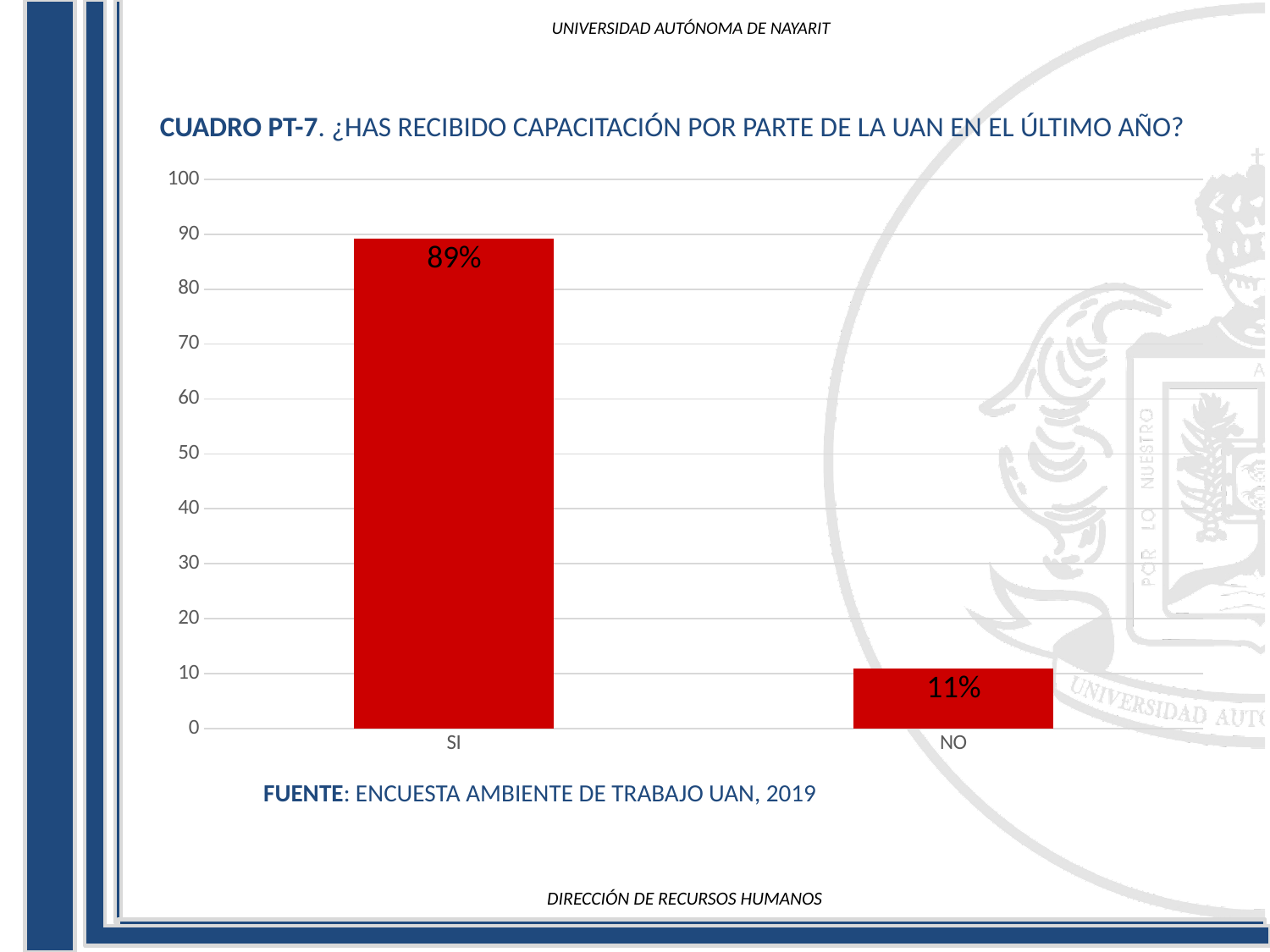
What is the value for SI? 89% What is the value for NO? 11% Is the value for NO greater or less than 20? less What kind of chart is shown on the slide? bar chart Which is larger, the value for SI or the value for NO? SI How many categories are shown on the x axis? 2 What colour are the bars in the chart? red What is the difference between the values for SI and NO? 78% Which category has the highest value? SI Is the value for SI greater or less than 80? greater What is the source cited below the chart? ENCUESTA AMBIENTE DE TRABAJO UAN, 2019 Which category has the lowest value? NO